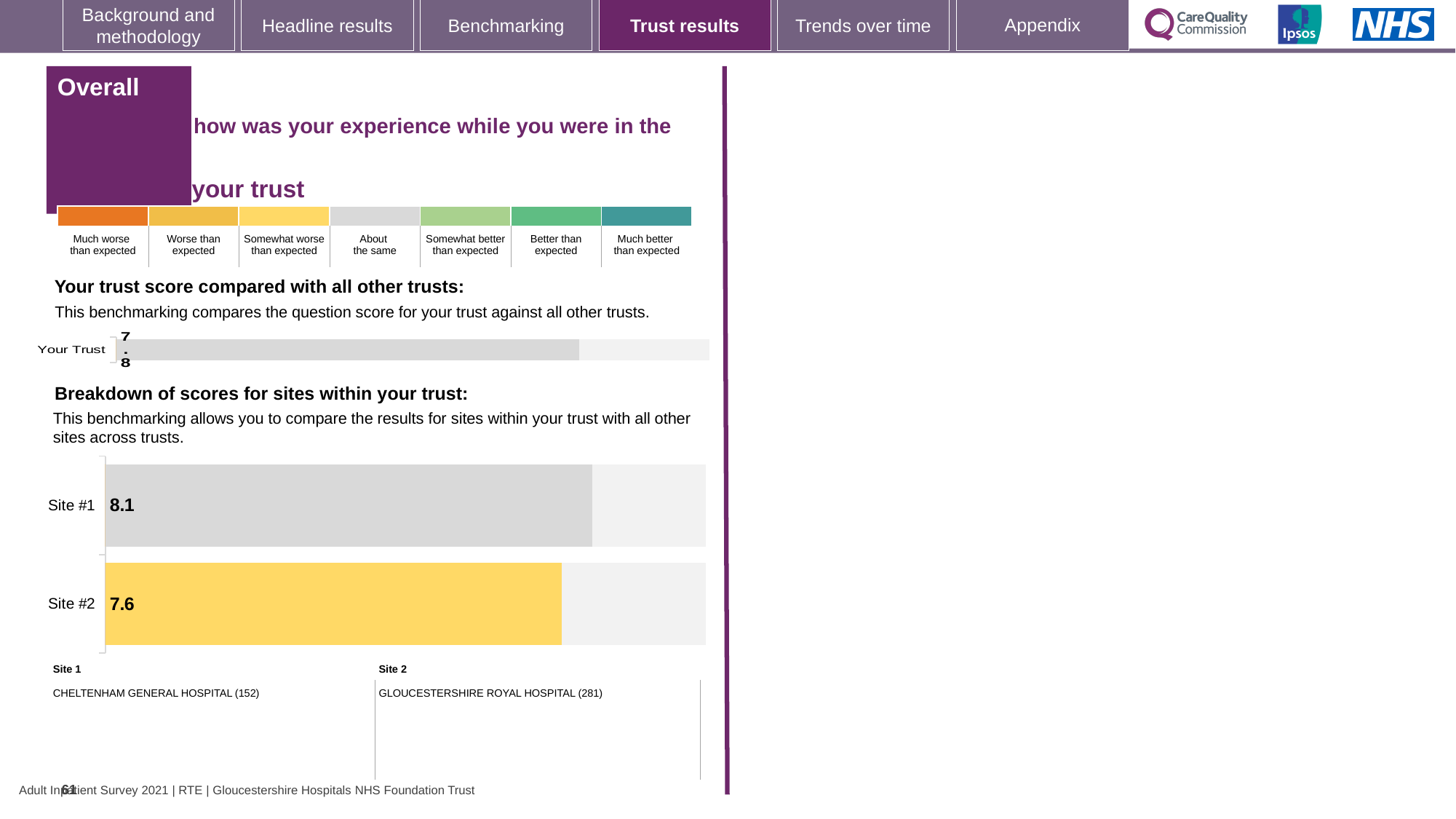
In the 'Breakdown of scores for sites within your trust' chart, which has the larger score, Site #1 or Site #2? Site #1 In the 'Breakdown of scores for sites within your trust' chart, what is the score for Site #2? 7.6 How many categories are plotted in the 'Your trust score compared with all other trusts' chart? 1 In the 'Breakdown of scores for sites within your trust' chart, which site has the highest score? Site #1 In the 'Breakdown of scores for sites within your trust' chart, what colour is the bar for Site #2? Yellow According to the slide, which hospital is Site 1? CHELTENHAM GENERAL HOSPITAL (152) How many sites are shown in the 'Breakdown of scores for sites within your trust' chart? 2 In the 'Your trust score compared with all other trusts' chart, what is the score for Your Trust? 7.8 In the 'Breakdown of scores for sites within your trust' chart, what is the difference between the scores for Site #1 and Site #2? 0.5 What kind of chart is the 'Breakdown of scores for sites within your trust' chart? Bar chart In the 'Breakdown of scores for sites within your trust' chart, which site has the lowest score? Site #2 In the 'Breakdown of scores for sites within your trust' chart, what is the score for Site #1? 8.1